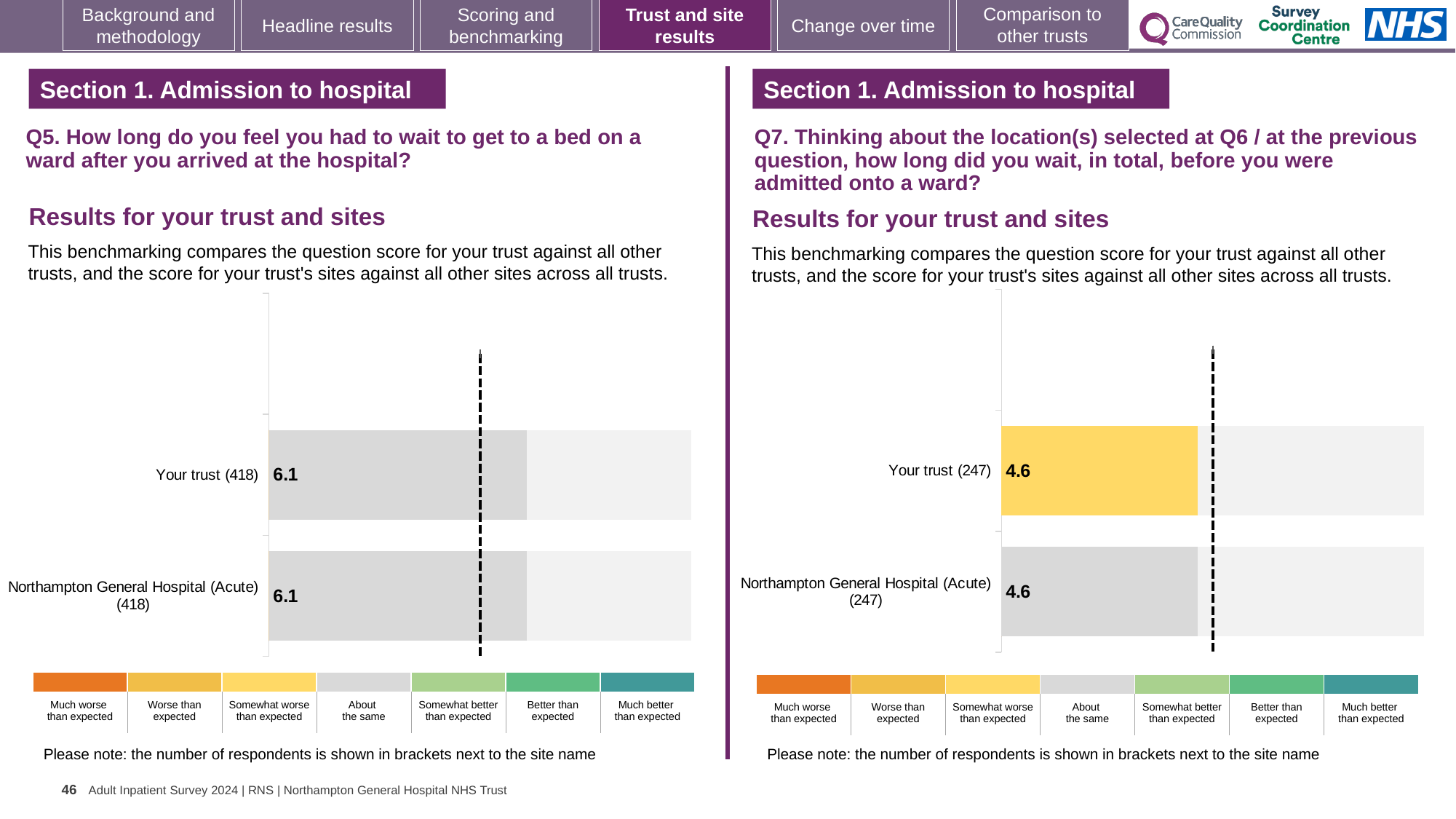
On the right chart (Q7), what is the score for Your trust (247)? 4.6 How many bars are plotted on the right chart (Q7)? 2 On the left chart (Q5), what is the score for Your trust (418)? 6.1 How many bars are plotted on the left chart (Q5)? 2 On the right chart (Q7), what is the difference between the score for Your trust and the score for Northampton General Hospital (Acute)? 0 How many categories does the colour key below the left chart (Q5) list? 7 On the right chart (Q7), how many respondents are shown in brackets for Your trust? 247 What kind of chart is used on the left (Q5)? Bar chart On the left chart (Q5), what is the difference between the score for Your trust and the score for Northampton General Hospital (Acute)? 0 On the right chart (Q7), what is the score for Northampton General Hospital (Acute) (247)? 4.6 On the right chart (Q7), which benchmark category does the colour of the Your trust bar correspond to according to the key? Somewhat worse than expected On the left chart (Q5), what is the score for Northampton General Hospital (Acute) (418)? 6.1